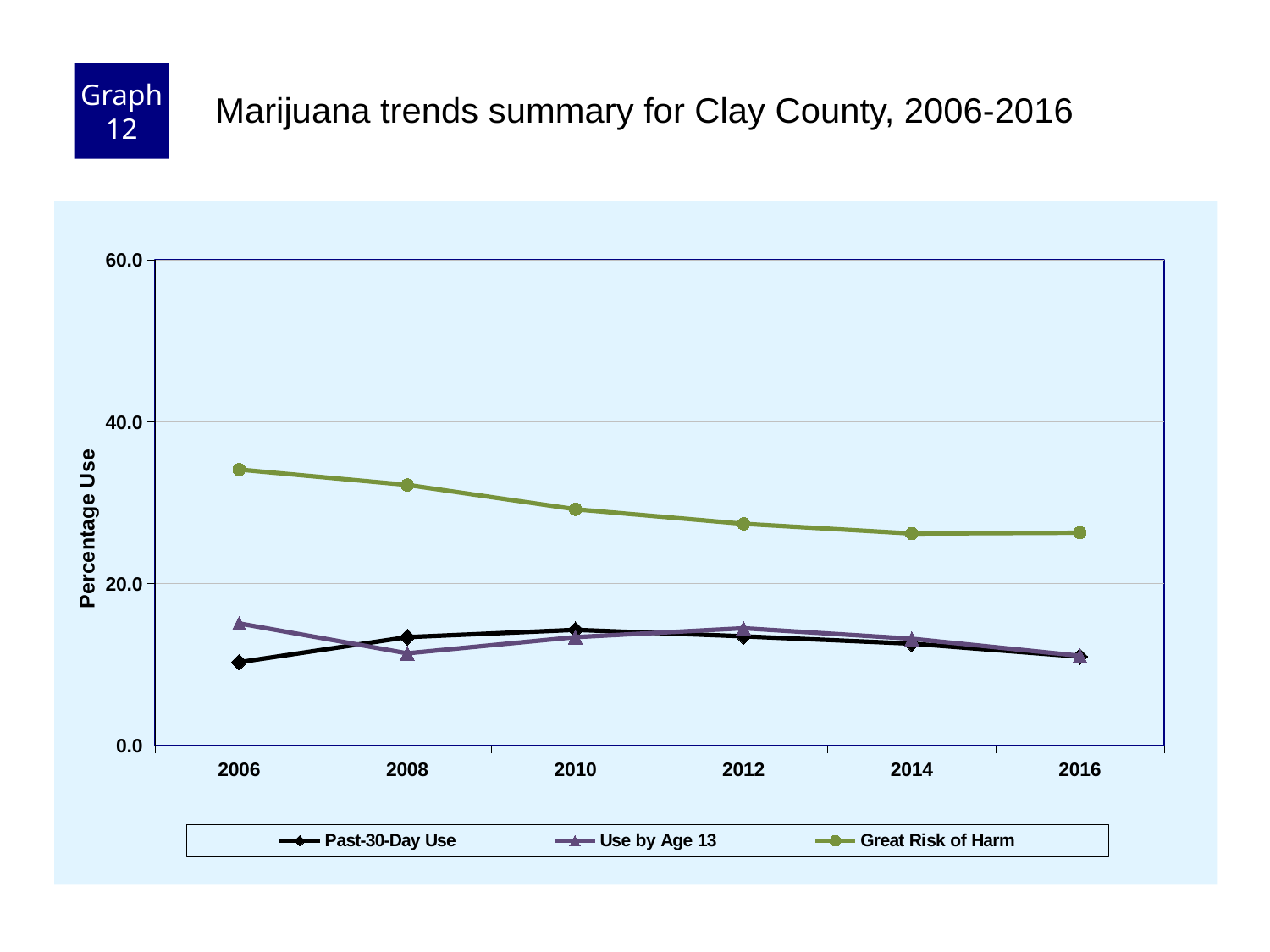
In which year is the Great Risk of Harm value highest? 2006 What is the label on the y axis? Percentage Use Does the Great Risk of Harm series rise or fall from 2006 to 2016? fall What is the title of the chart? Marijuana trends summary for Clay County, 2006-2016 Is the Past-30-Day Use value for 2010 greater or less than 20.0? less How many series does the legend list? 3 In 2008, which is larger: Past-30-Day Use or Use by Age 13? Past-30-Day Use In 2006, which is larger: Use by Age 13 or Past-30-Day Use? Use by Age 13 What kind of chart is shown on the slide? line chart Is the Great Risk of Harm value for 2016 greater or less than 20.0? greater Is the Great Risk of Harm value for 2006 greater or less than 40.0? less How many years are plotted along the x axis? 6